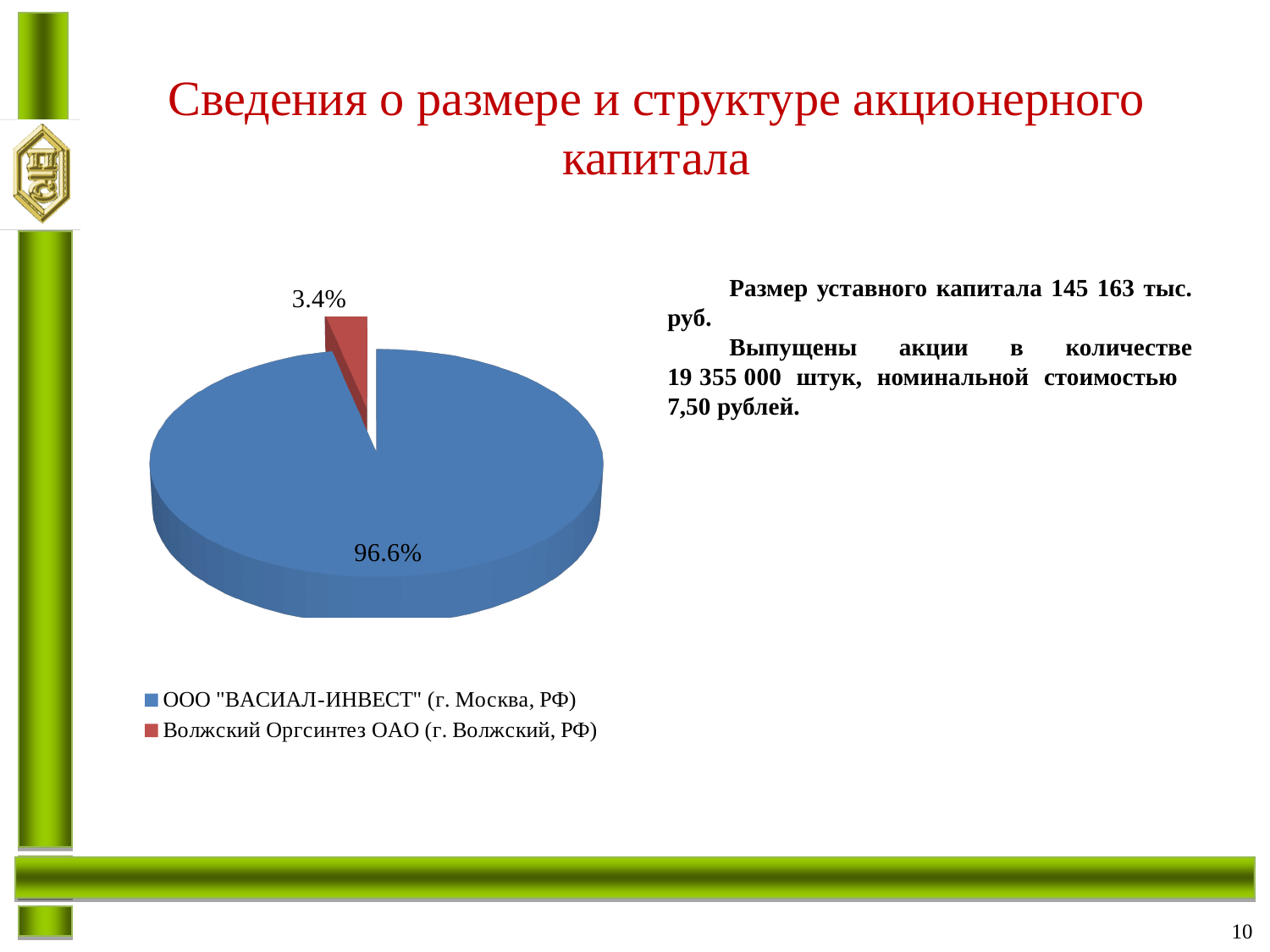
What is the difference in percentage points between the share of ООО "ВАСИАЛ-ИНВЕСТ" and the share of Волжский Оргсинтез ОАО? 93.2% How many entries does the legend list? 2 What colour is the slice for ООО "ВАСИАЛ-ИНВЕСТ" (г. Москва, РФ)? blue Which shareholder has the smallest slice of the pie? Волжский Оргсинтез ОАО (г. Волжский, РФ) Which shareholder has the largest slice of the pie? ООО "ВАСИАЛ-ИНВЕСТ" (г. Москва, РФ) How many slices does the pie chart have? 2 What share of the pie does Волжский Оргсинтез ОАО (г. Волжский, РФ) hold? 3.4% What kind of chart is shown on the slide? pie chart Which is larger: the share of ООО "ВАСИАЛ-ИНВЕСТ" or the share of Волжский Оргсинтез ОАО? ООО "ВАСИАЛ-ИНВЕСТ" What share of the pie does ООО "ВАСИАЛ-ИНВЕСТ" (г. Москва, РФ) hold? 96.6% What colour is the slice for Волжский Оргсинтез ОАО (г. Волжский, РФ)? red